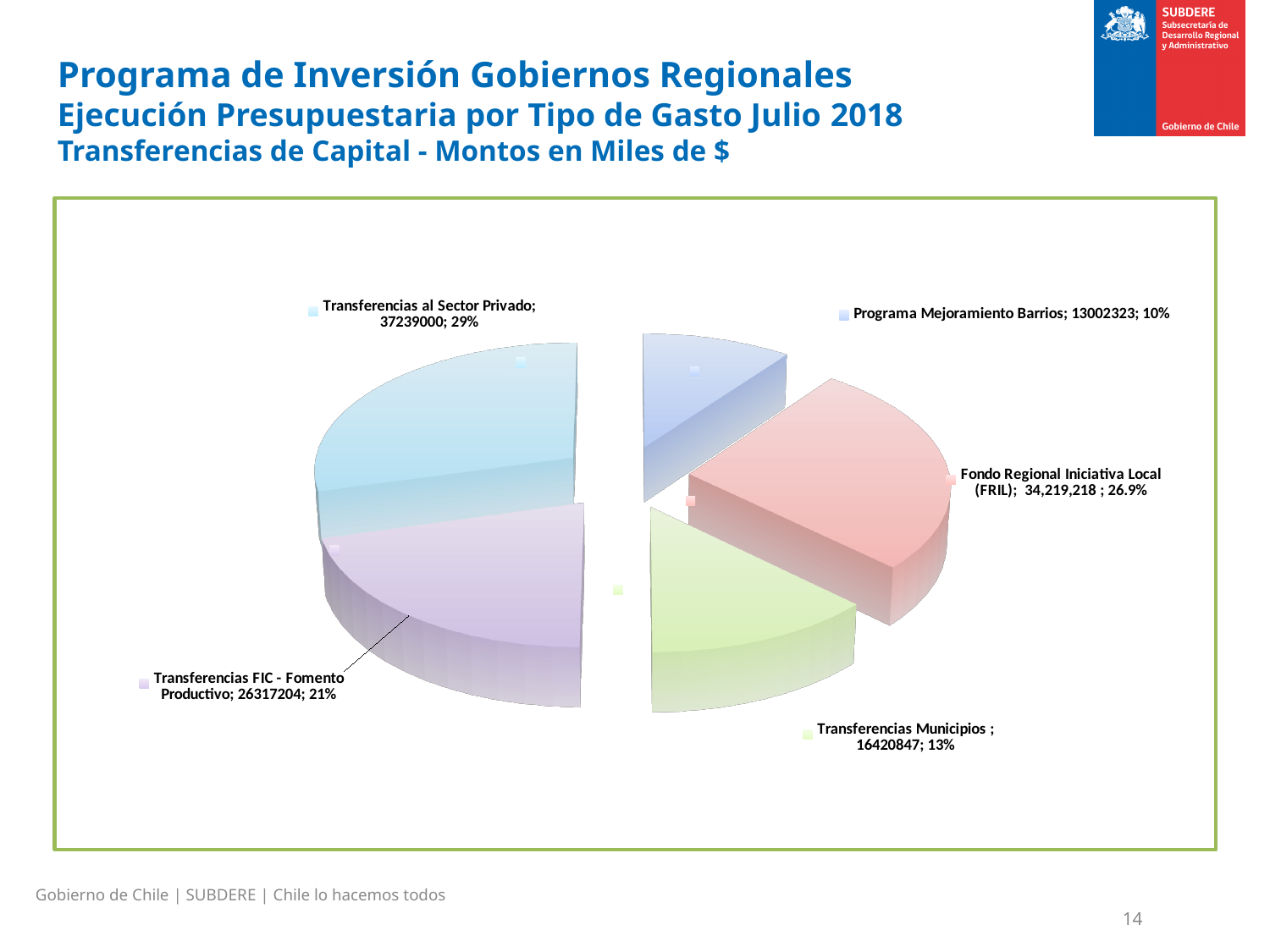
What is the value shown for Transferencias Municipios? 16420847 What kind of chart is shown on the slide? Pie chart Which category has the smallest slice of the pie? Programa Mejoramiento Barrios How many slices does the pie chart have? 5 What is the value shown for Transferencias al Sector Privado? 37239000 What is the difference between the values for Transferencias FIC - Fomento Productivo and Transferencias Municipios? 9896357 What share of the pie does Transferencias FIC - Fomento Productivo represent? 21% Which is larger, the value for Transferencias Municipios or the value for Programa Mejoramiento Barrios? Transferencias Municipios What share of the pie does Fondo Regional Iniciativa Local (FRIL) represent? 26.9% Which category has the largest slice of the pie? Transferencias al Sector Privado What is the value shown for Programa Mejoramiento Barrios? 13002323 What is the value shown for Fondo Regional Iniciativa Local (FRIL)? 34,219,218